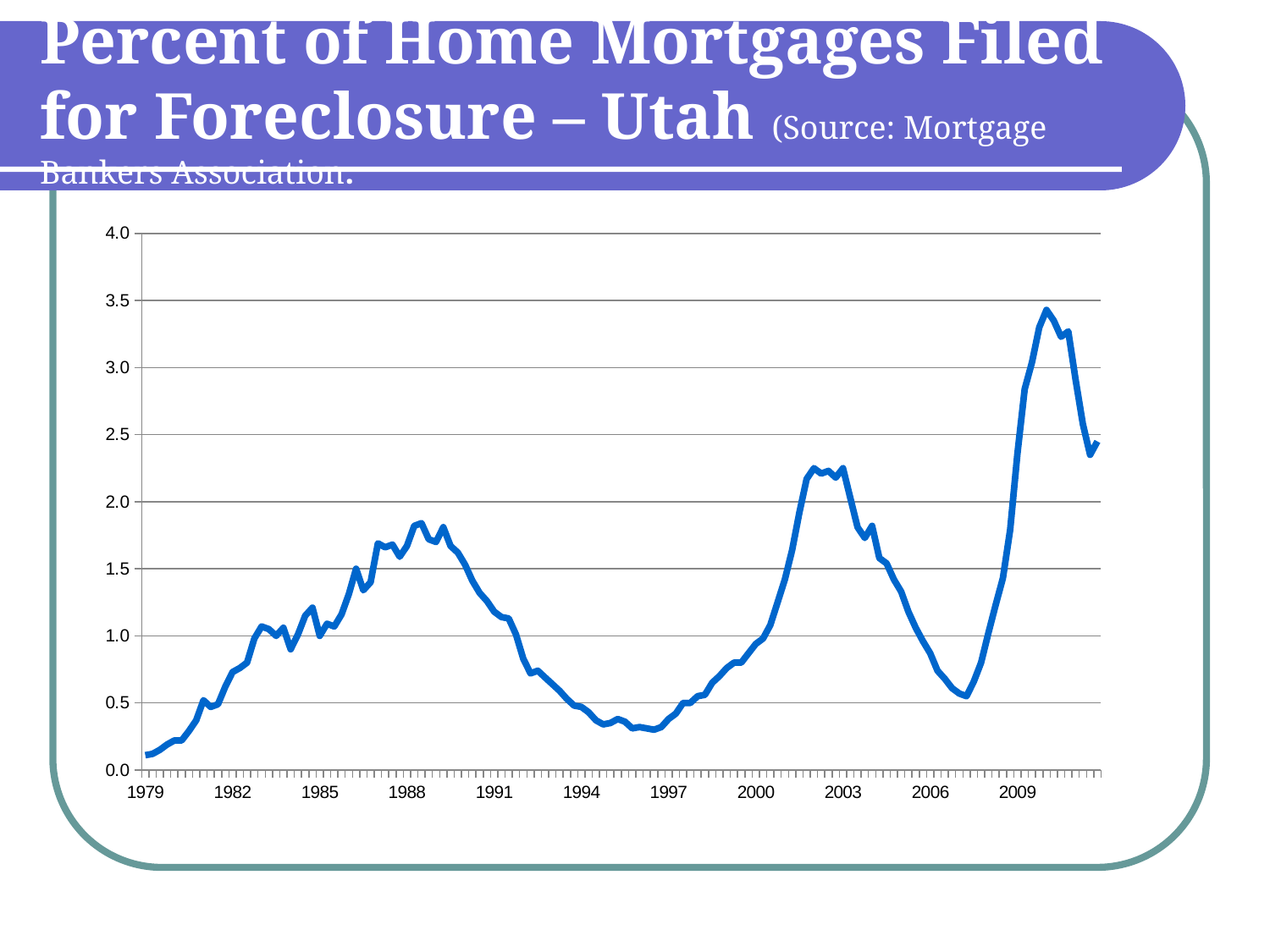
Is the value for 1982 greater or less than 1.0? less Is the value for 2003 greater or less than 2.0? greater Is the value for 1997 greater or less than 0.5? less What kind of chart is shown on the slide? line chart Does the line rise or fall between 1997 and 2003? rise Does the line rise or fall between 1988 and 1997? fall What is the first year labeled on the horizontal axis? 1979 Does the line rise or fall between 1979 and 1988? rise What is the highest value shown on the vertical axis? 4.0